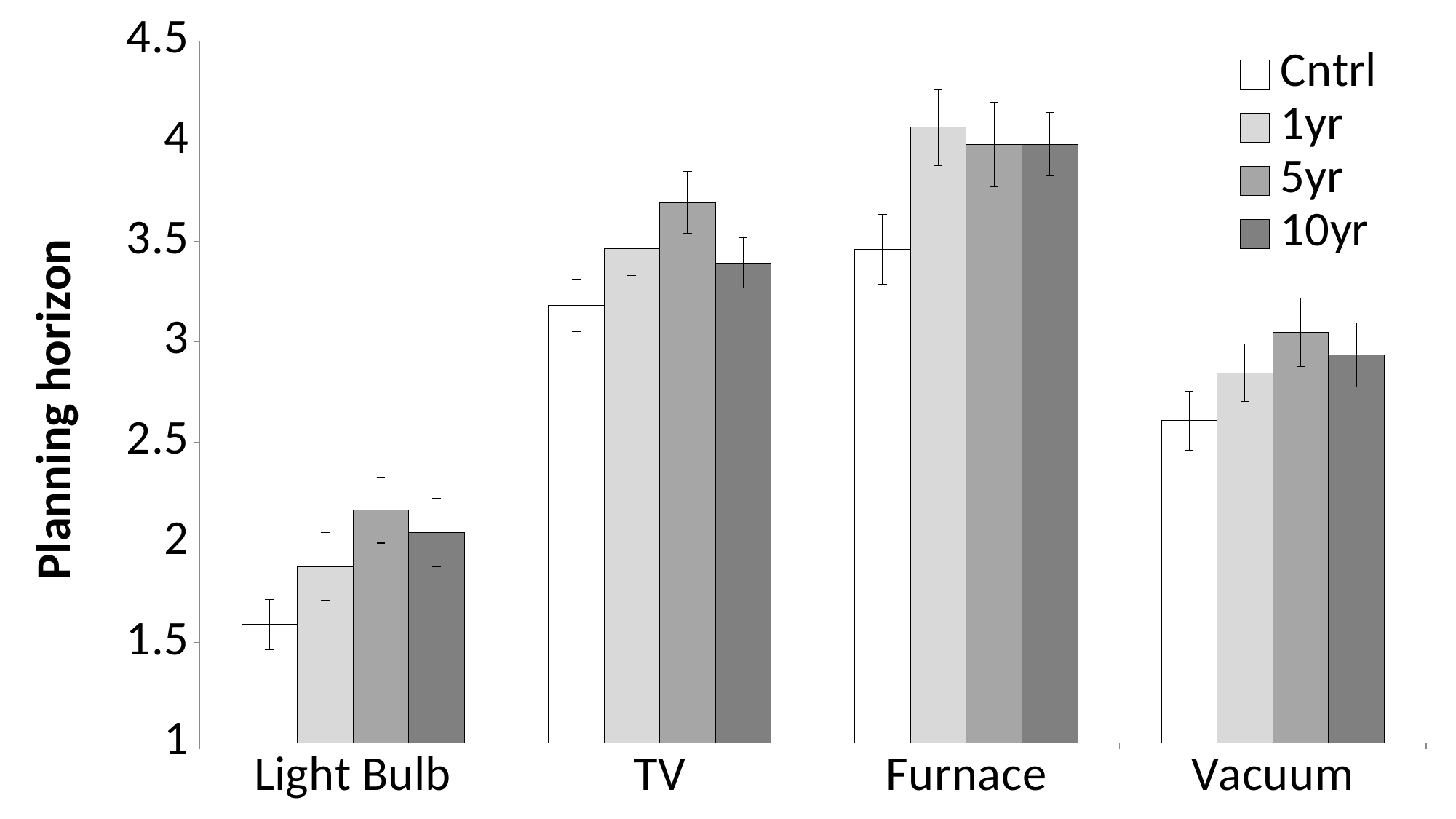
Is the Cntrl value for TV greater or less than 3? greater Which product category has the highest Cntrl value? Furnace For TV, which series has the highest planning horizon? 5yr What are the four legend entries? Cntrl, 1yr, 5yr, 10yr How many series does the legend list? 4 What kind of chart is shown on the slide? bar chart Is the Cntrl value for Light Bulb greater or less than 2? less How many product categories are shown on the x axis? 4 Which product category has the lowest Cntrl value? Light Bulb Is the Cntrl value for Vacuum greater or less than 2.5? greater What is the title of the y axis? Planning horizon